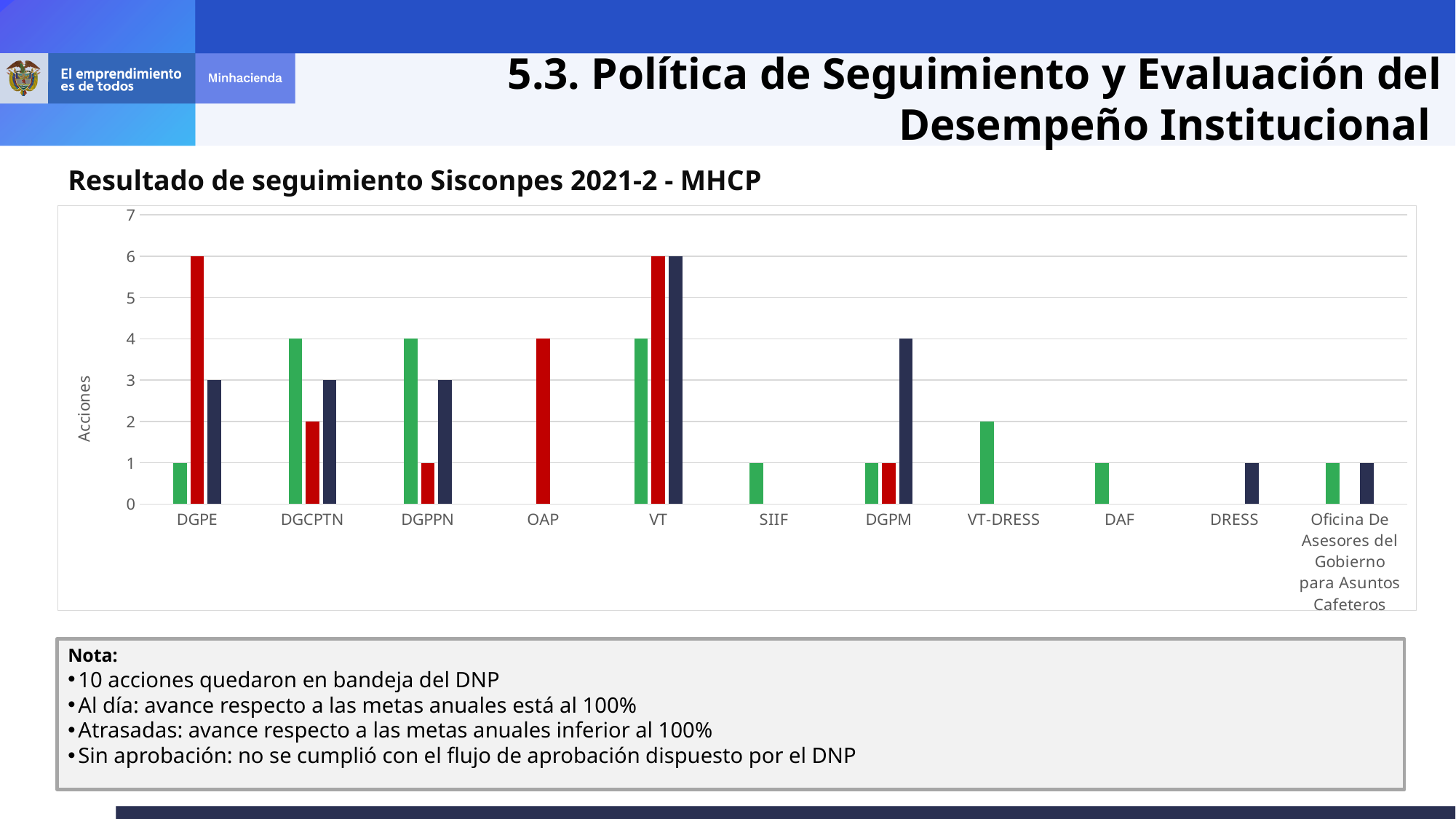
What kind of chart is shown on the slide? bar chart What is the value of the dark navy bar for DGPM? 4 Is the value of the green bar for VT-DRESS greater or less than 3? less What is the label of the vertical axis? Acciones For DGCPTN, which is larger: the green bar or the red bar? green bar What is the value of the green bar for DGCPTN? 4 What is the value of the red bar for OAP? 4 What is the value of the red bar for DGPE? 6 What is the difference between the red bar and the green bar for DGPE? 5 What is the title of the chart? Resultado de seguimiento Sisconpes 2021-2 - MHCP Which category has the highest dark navy bar? VT How many categories are shown on the x axis? 11